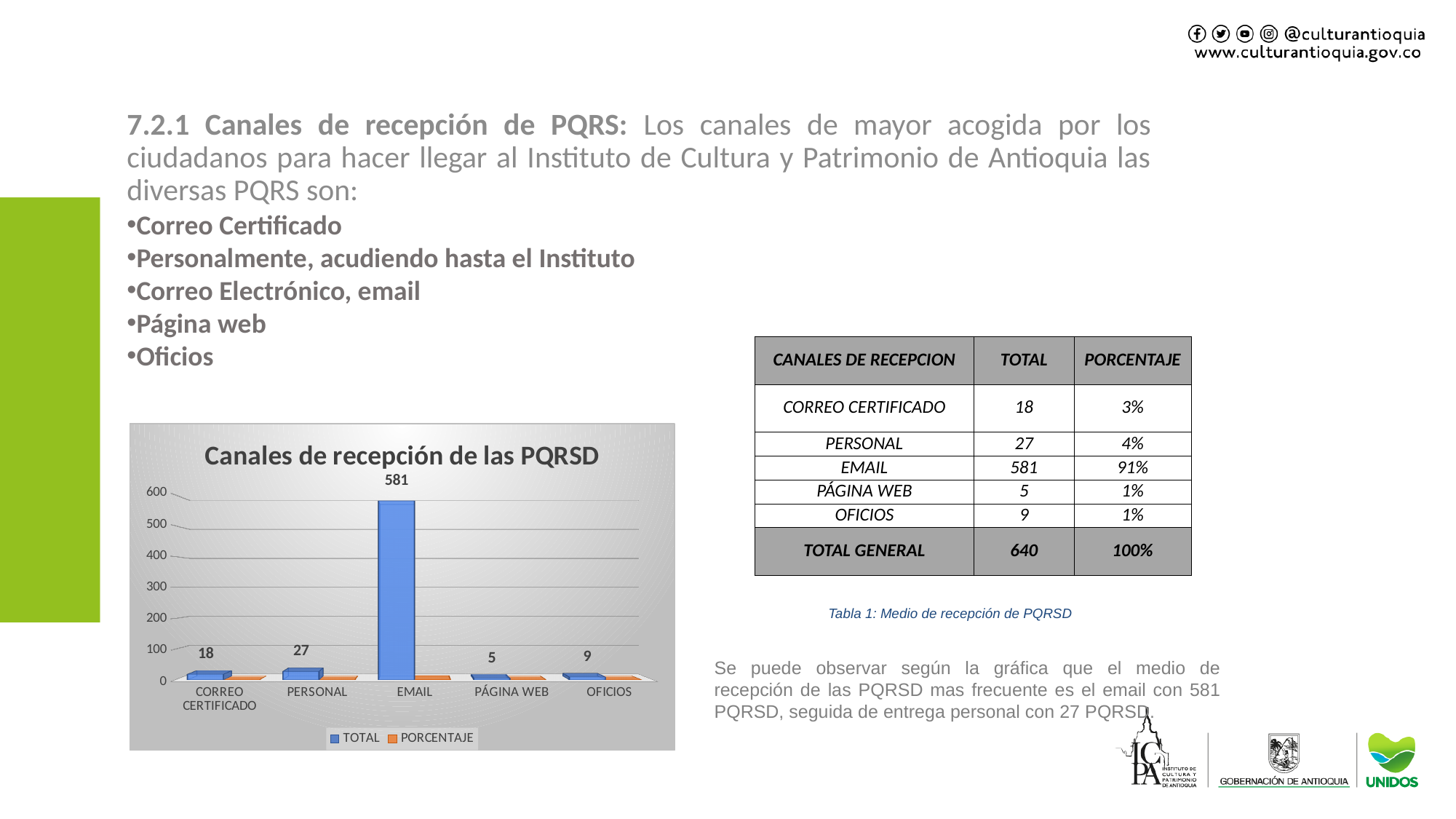
What is the difference between the TOTAL values for EMAIL and PERSONAL? 554 Which category has the highest TOTAL value in the chart? EMAIL What is the title of the chart? Canales de recepción de las PQRSD What is the TOTAL value for PERSONAL in the chart? 27 What is the TOTAL value for CORREO CERTIFICADO in the chart? 18 What is the TOTAL value for PÁGINA WEB in the chart? 5 Which category has the lowest TOTAL value in the chart? PÁGINA WEB How many categories are shown on the x axis of the chart? 5 How many series does the chart legend list? 2 What is the TOTAL value for EMAIL in the chart? 581 What is the TOTAL value for OFICIOS in the chart? 9 Which has a larger TOTAL value, CORREO CERTIFICADO or PERSONAL? PERSONAL